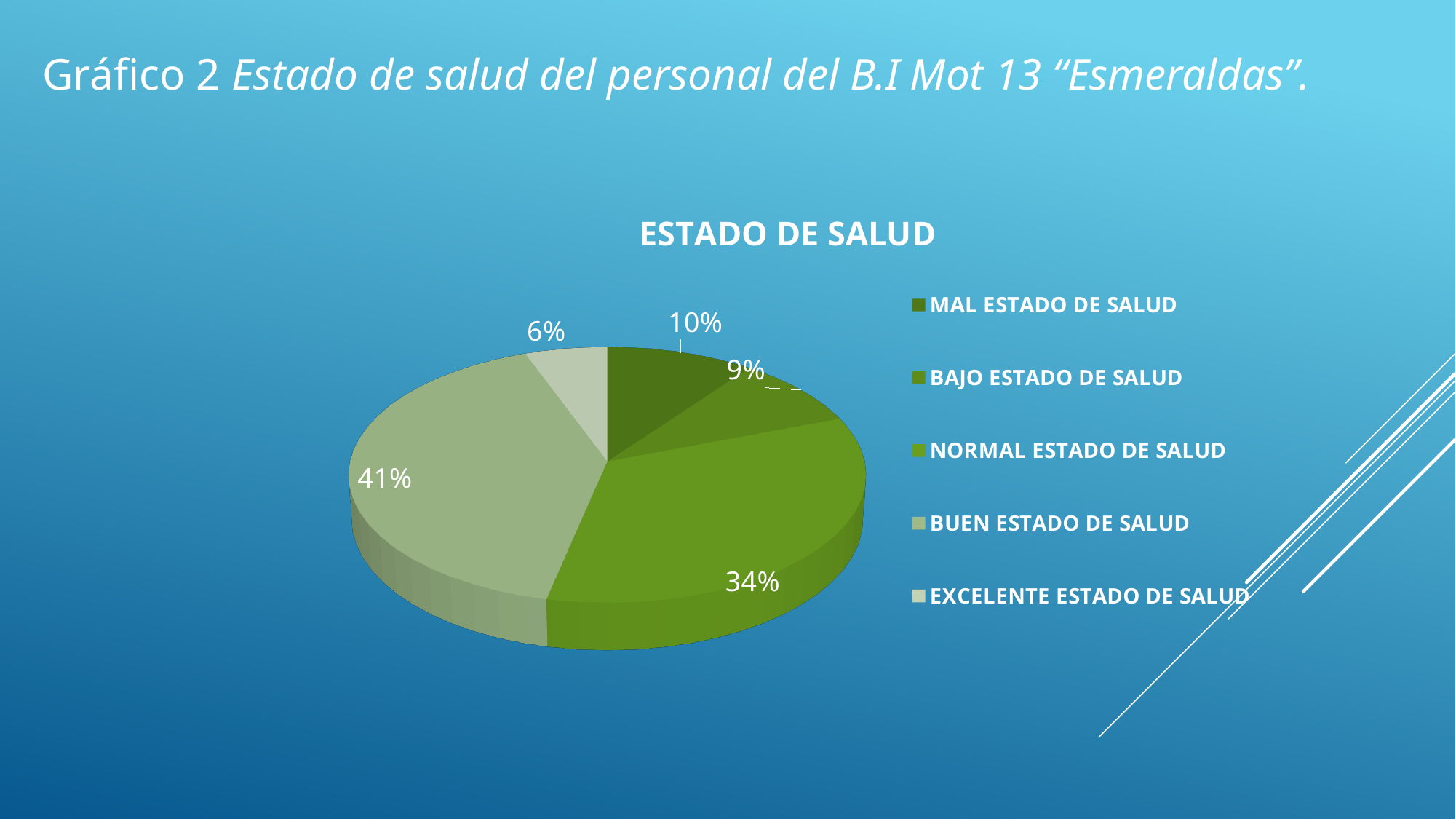
Which category has the smallest share of the pie? EXCELENTE ESTADO DE SALUD What percentage of the pie is labelled for BUEN ESTADO DE SALUD? 41% What percentage is shown for NORMAL ESTADO DE SALUD? 34% How many categories does the pie chart show? 5 What is the combined percentage of MAL ESTADO DE SALUD and BAJO ESTADO DE SALUD? 19% What kind of chart is shown on the slide? Pie chart What is the title of the chart? ESTADO DE SALUD What percentage is shown for EXCELENTE ESTADO DE SALUD? 6% Which is larger, the share for MAL ESTADO DE SALUD or BAJO ESTADO DE SALUD? MAL ESTADO DE SALUD Which category has the largest share of the pie? BUEN ESTADO DE SALUD What percentage is shown for MAL ESTADO DE SALUD? 10% What is the difference in percentage points between BUEN ESTADO DE SALUD and NORMAL ESTADO DE SALUD? 7